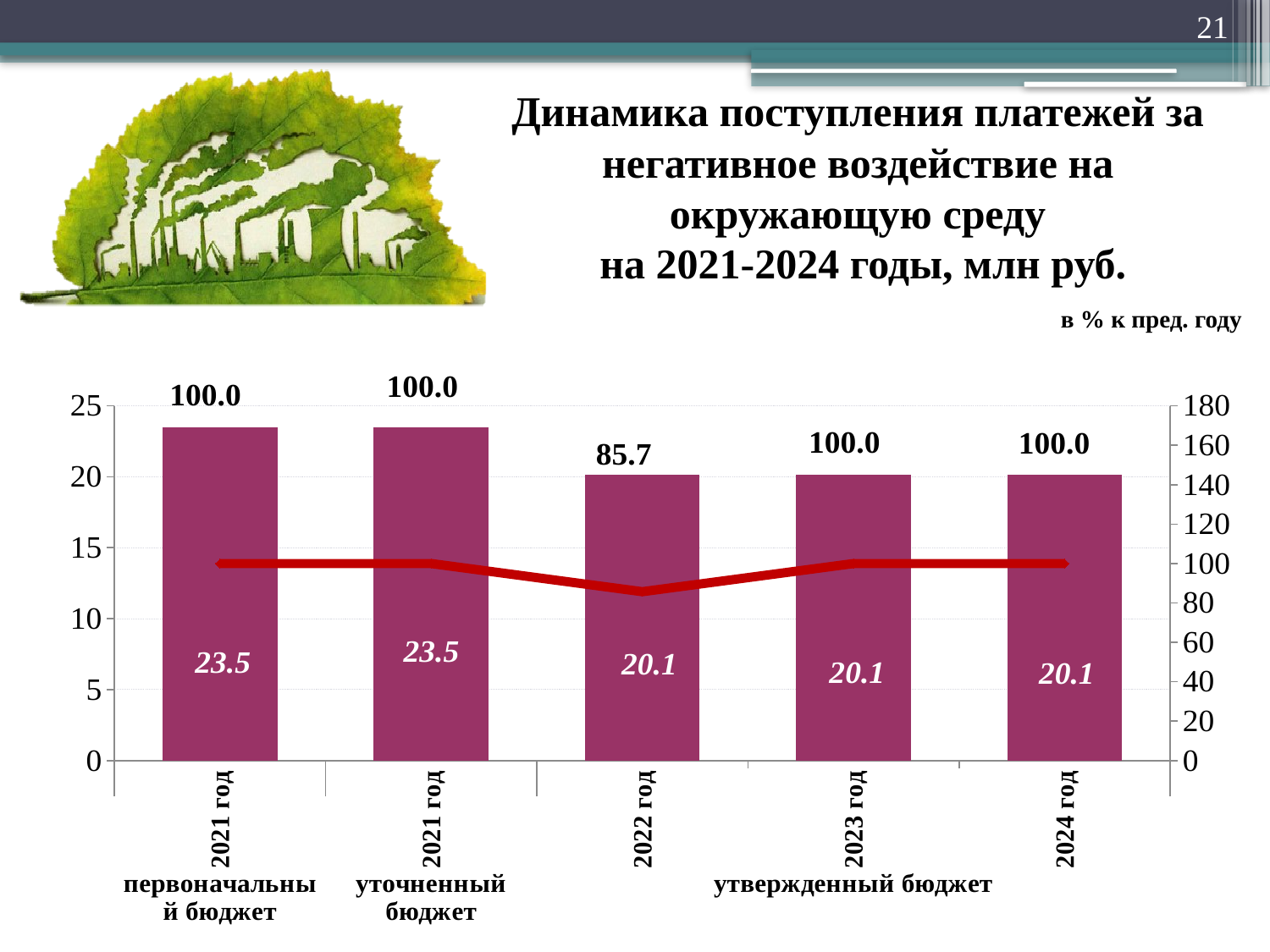
Which is larger: the bar for 2021 год (первоначальный бюджет) or the bar for 2023 год? 2021 год (первоначальный бюджет) Do the bar values rise or fall from 2021 год (уточненный бюджет) to 2022 год? fall What is the maximum value shown on the right-hand axis? 180 Which year has the lowest percentage to the previous year on the line? 2022 год What is the percentage to the previous year shown for 2024 год? 100.0 What is the value in million rubles for 2021 год (первоначальный бюджет)? 23.5 Is the bar value for 2024 год greater or less than 15 on the left axis? greater What is the difference in million rubles between 2021 год (уточненный бюджет) and 2022 год? 3.4 What kind of chart is shown on the slide? Combined bar and line chart What is the percentage to the previous year shown for 2022 год? 85.7 What is the value in million rubles for 2022 год (утвержденный бюджет)? 20.1 How many bars are plotted on the chart? 5